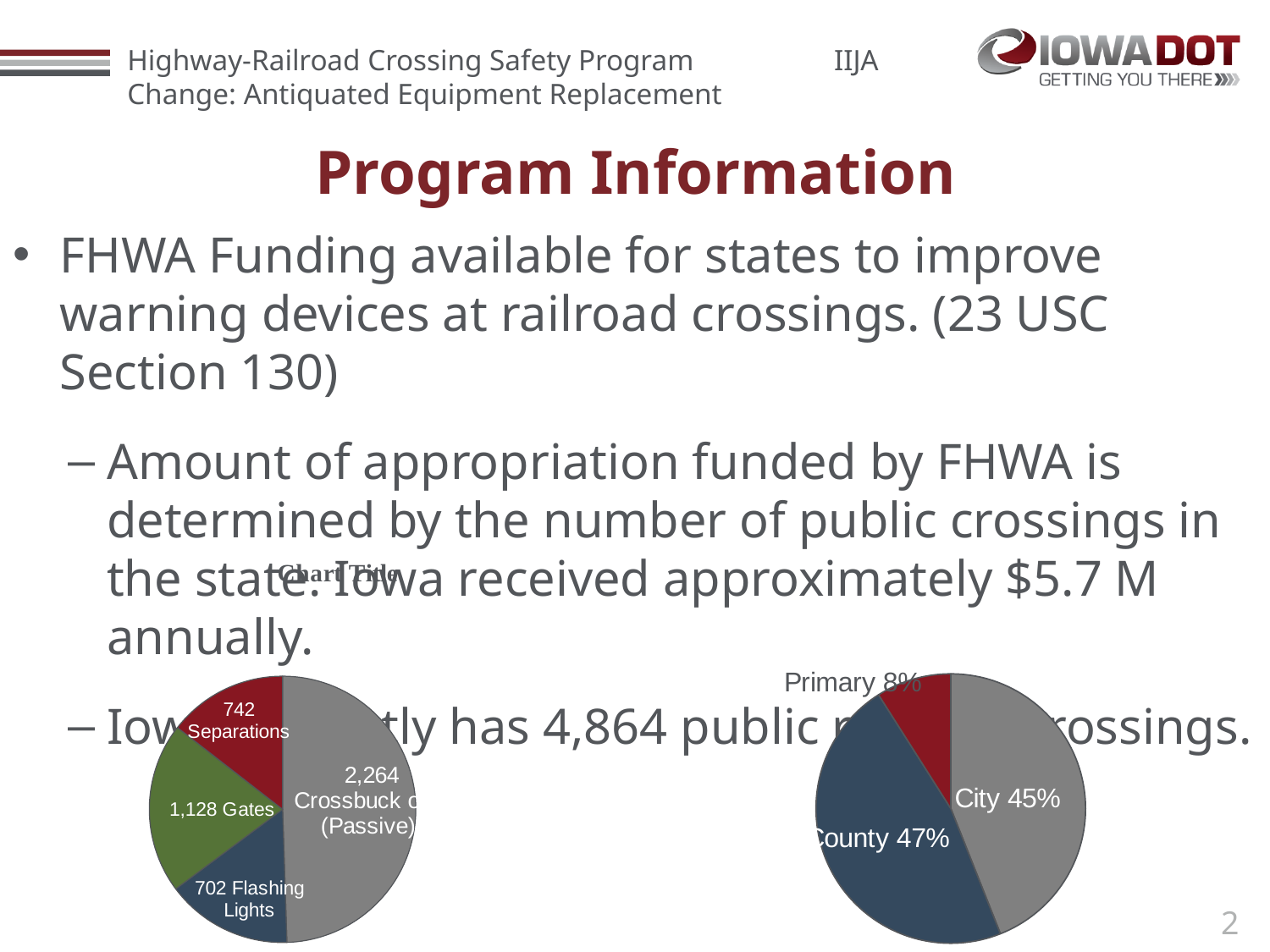
In the left pie chart, which is larger: Gates or Separations? Gates In the left pie chart, how many crossings have Flashing Lights? 702 In the left pie chart, how many crossings have Gates? 1,128 In the right pie chart, which category has the smallest share? Primary In the right pie chart, what share is labelled for County? 47% In the right pie chart, what is the difference between the County share and the City share? 2% In the left pie chart, which category has the smallest value? Flashing Lights In the left pie chart, what is the value for Separations? 742 In the left pie chart, what is the difference between the Gates value and the Flashing Lights value? 426 How many slices does the left pie chart have? 4 What kind of chart is the chart on the right of the slide? Pie chart In the left pie chart, which category has the largest value? Crossbuck (Passive)